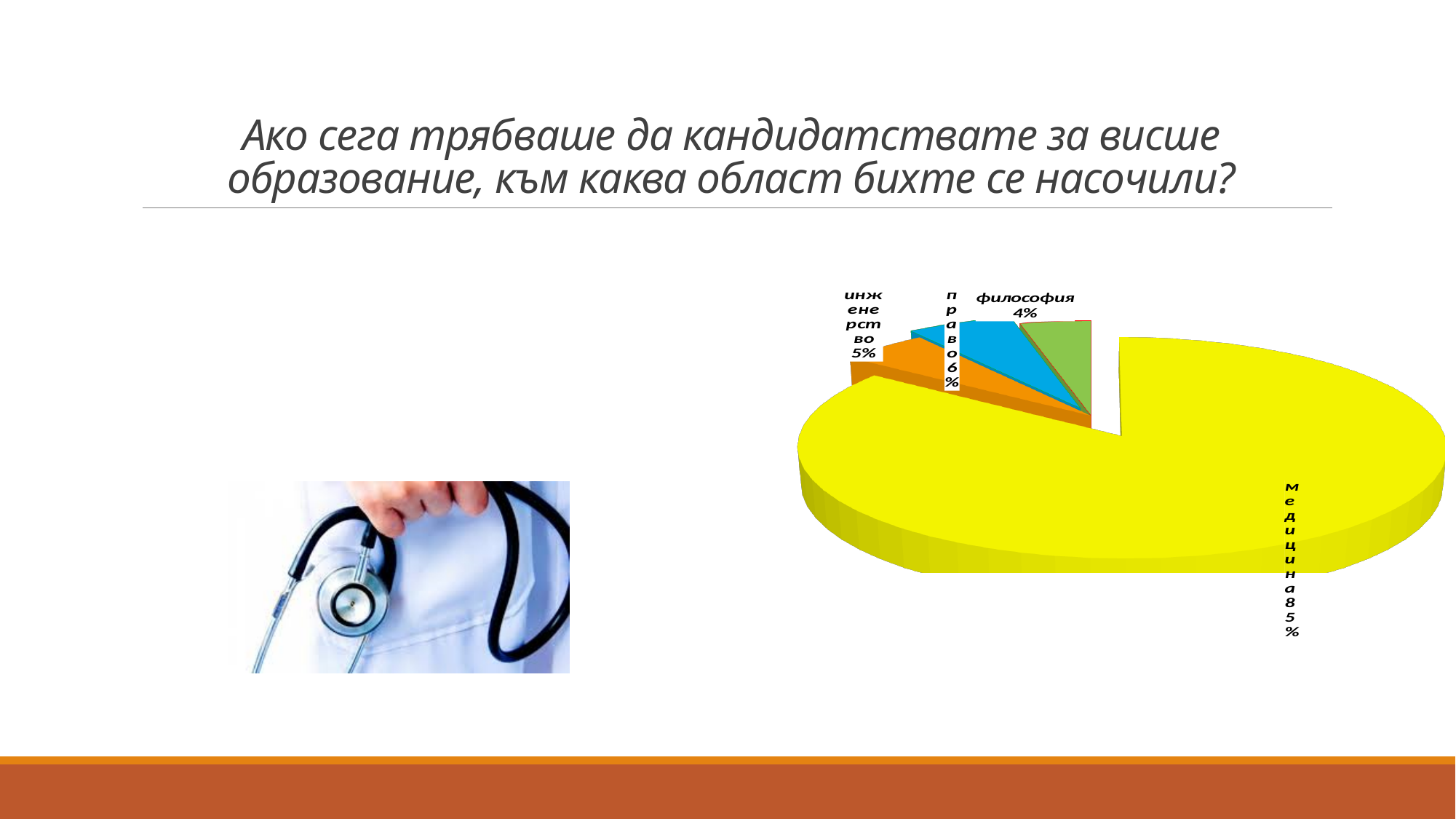
What kind of chart is shown on the slide? Pie chart By how many percentage points does медицина exceed философия? 81 percentage points What share of the pie does медицина have? 85% What percentage is shown for инженерство? 5% By how many percentage points does право exceed инженерство? 1 percentage point Which category has the largest slice of the pie? медицина Which category has the smallest slice of the pie? философия What percentage is shown for философия? 4% What percentage is shown for право? 6% How many slices does the pie chart have? 4 Which is larger, the share for право or the share for философия? право What colour is the медицина slice? Yellow